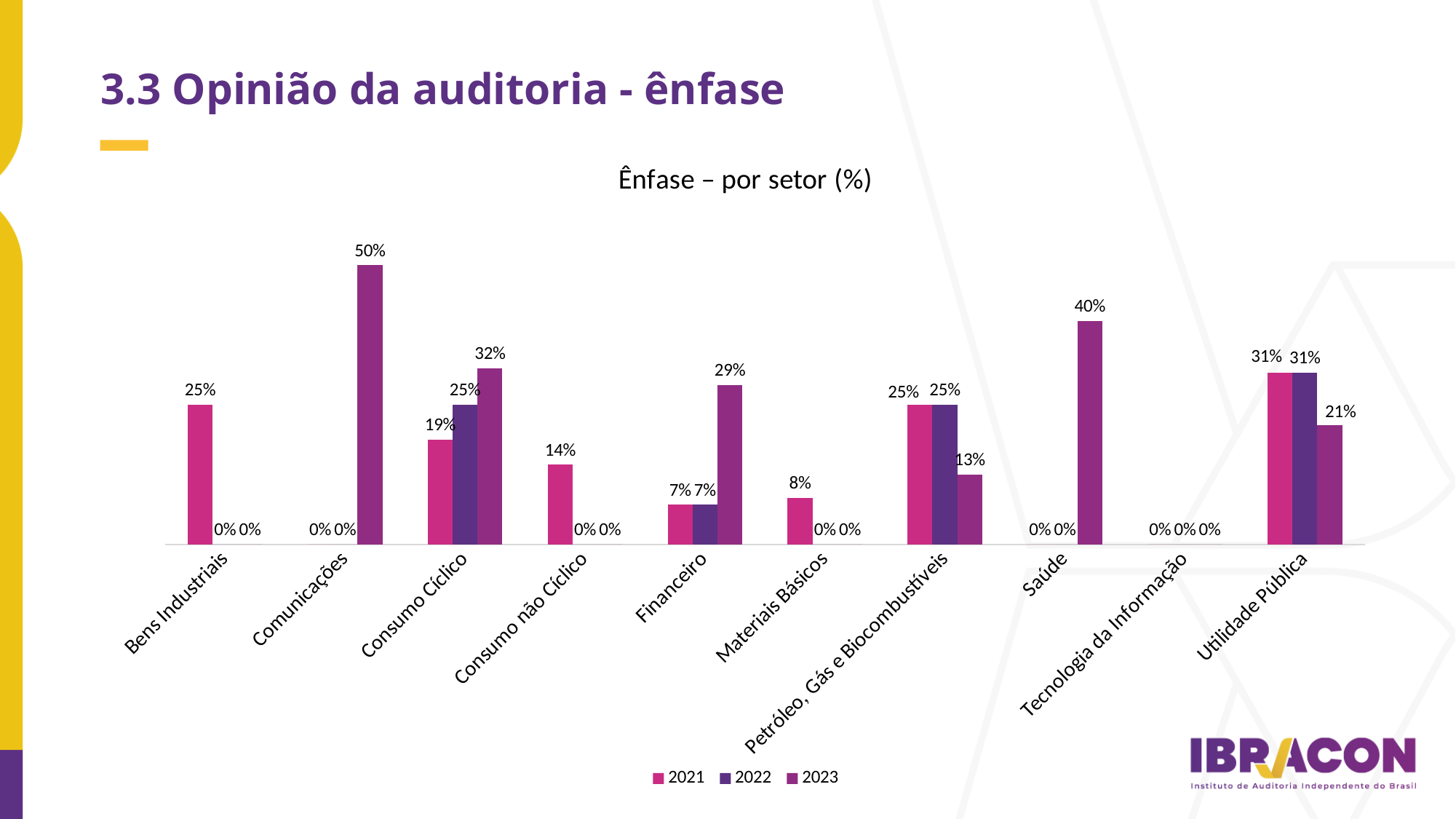
How many sectors are shown on the x axis? 10 What is the 2023 value for Comunicações? 50% What is the 2022 value for Utilidade Pública? 31% What is the 2021 value for Consumo Cíclico? 19% Which sector has the highest 2023 value? Comunicações Which sector has the highest 2021 value? Utilidade Pública What kind of chart is shown on the slide? Bar chart What is the difference between the 2023 and 2021 values for Consumo Cíclico? 13% Which is larger for Financeiro: the 2023 value or the 2021 value? 2023 What is the title of the chart? Ênfase – por setor (%) How many series does the legend list? 3 What is the 2023 value for Petróleo, Gás e Biocombustíveis? 13%